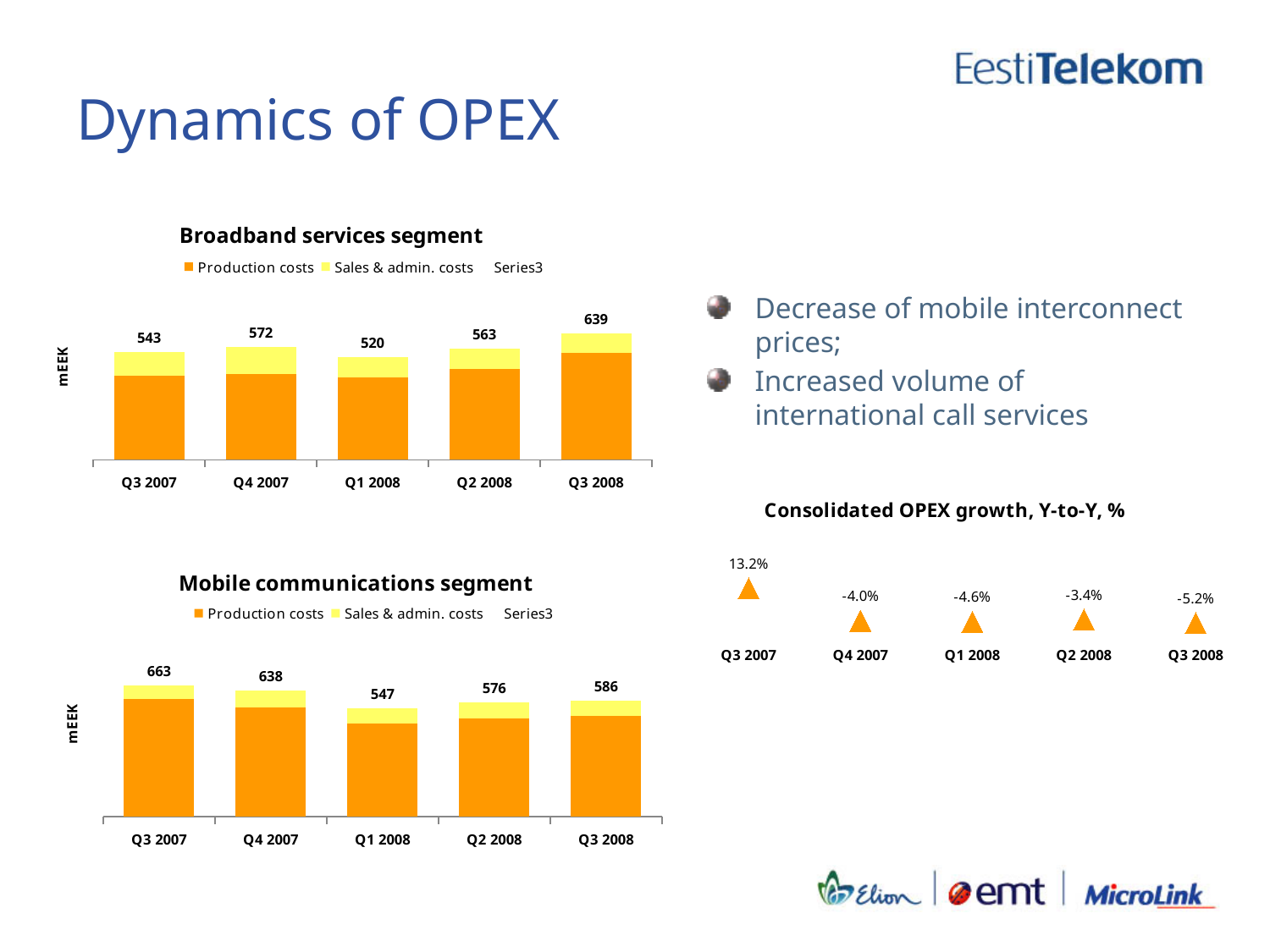
In the Broadband services segment chart, what is the total value labelled for Q3 2008? 639 How many series does the legend of the Mobile communications segment chart list? 3 In the Consolidated OPEX growth, Y-to-Y, % chart, what is the value for Q3 2007? 13.2% In the Consolidated OPEX growth, Y-to-Y, % chart, which quarter has the lowest value? Q3 2008 What kind of chart is the Broadband services segment chart? Stacked bar chart In the Broadband services segment chart, what is the difference between the totals for Q3 2008 and Q3 2007? 96 In the Broadband services segment chart, which quarter has the lowest total? Q1 2008 In the Mobile communications segment chart, what is the difference between the totals for Q3 2007 and Q3 2008? 77 In the Mobile communications segment chart, what is the total value labelled for Q1 2008? 547 How many quarters are shown on the x axis of the Broadband services segment chart? 5 In the Mobile communications segment chart, is the total for Q4 2007 or Q2 2008 larger? Q4 2007 In the Mobile communications segment chart, which quarter has the highest total? Q3 2007